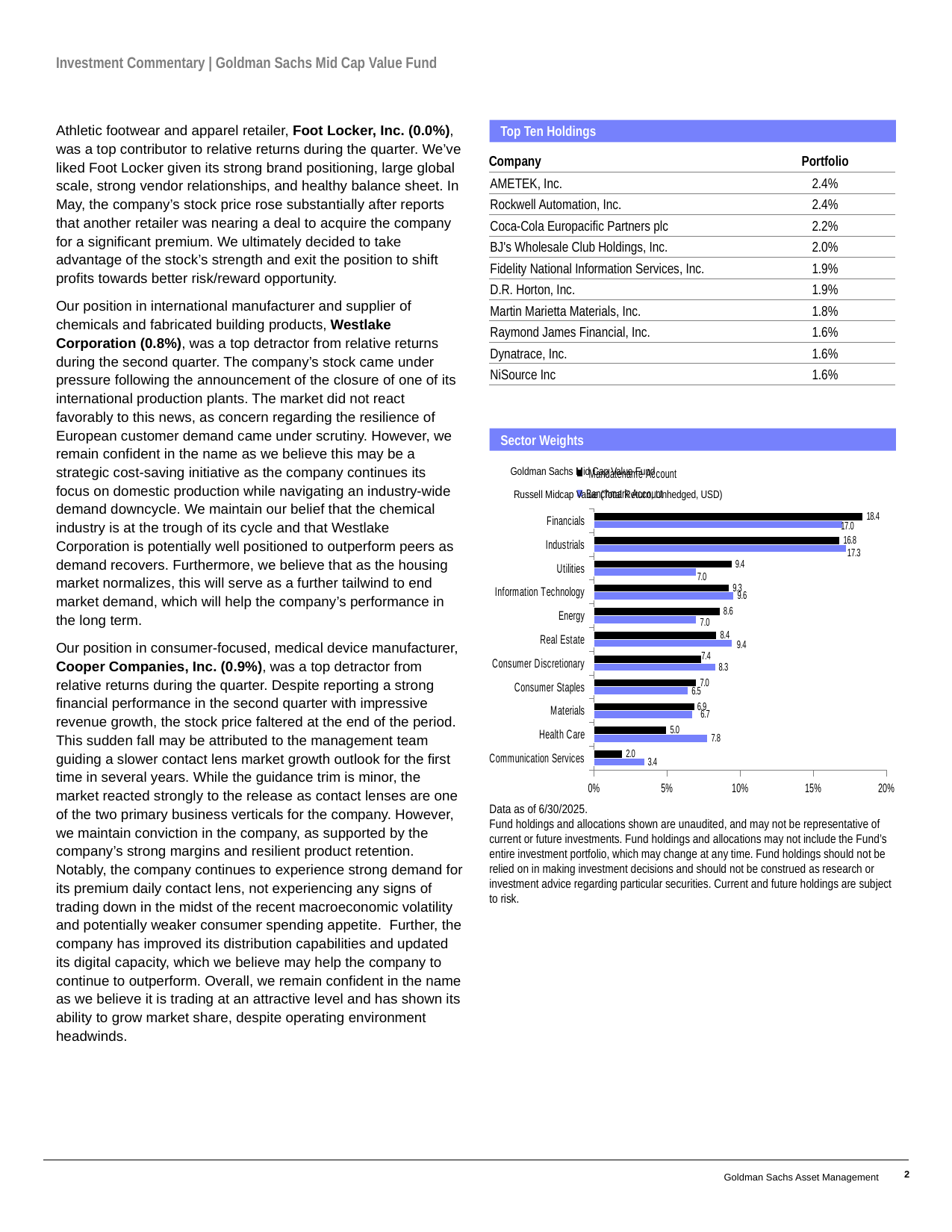
What kind of chart is the Sector Weights chart? bar chart On the Sector Weights chart, what is the benchmark (blue bar) weight for Health Care? 7.8 On the Sector Weights chart, what is the Goldman Sachs Mid Cap Value Fund (black bar) weight for Utilities? 9.4 How many sectors are shown on the Sector Weights chart? 11 On the Sector Weights chart, what is the difference between the fund (black bar) and benchmark (blue bar) weights for Health Care? 2.8 On the Sector Weights chart, what is the Goldman Sachs Mid Cap Value Fund (black bar) weight for Financials? 18.4 On the Sector Weights chart, what colour are the bars for the Goldman Sachs Mid Cap Value Fund? black On the Sector Weights chart, is the fund (black bar) weight for Industrials greater or less than 15%? greater On the Sector Weights chart, is the fund (black bar) weight for Real Estate larger or smaller than the benchmark (blue bar) weight for Real Estate? smaller How many series does the Sector Weights chart plot? 2 On the Sector Weights chart, which sector has the lowest benchmark (blue bar) weight? Communication Services On the Sector Weights chart, which sector has the highest Goldman Sachs Mid Cap Value Fund (black bar) weight? Financials